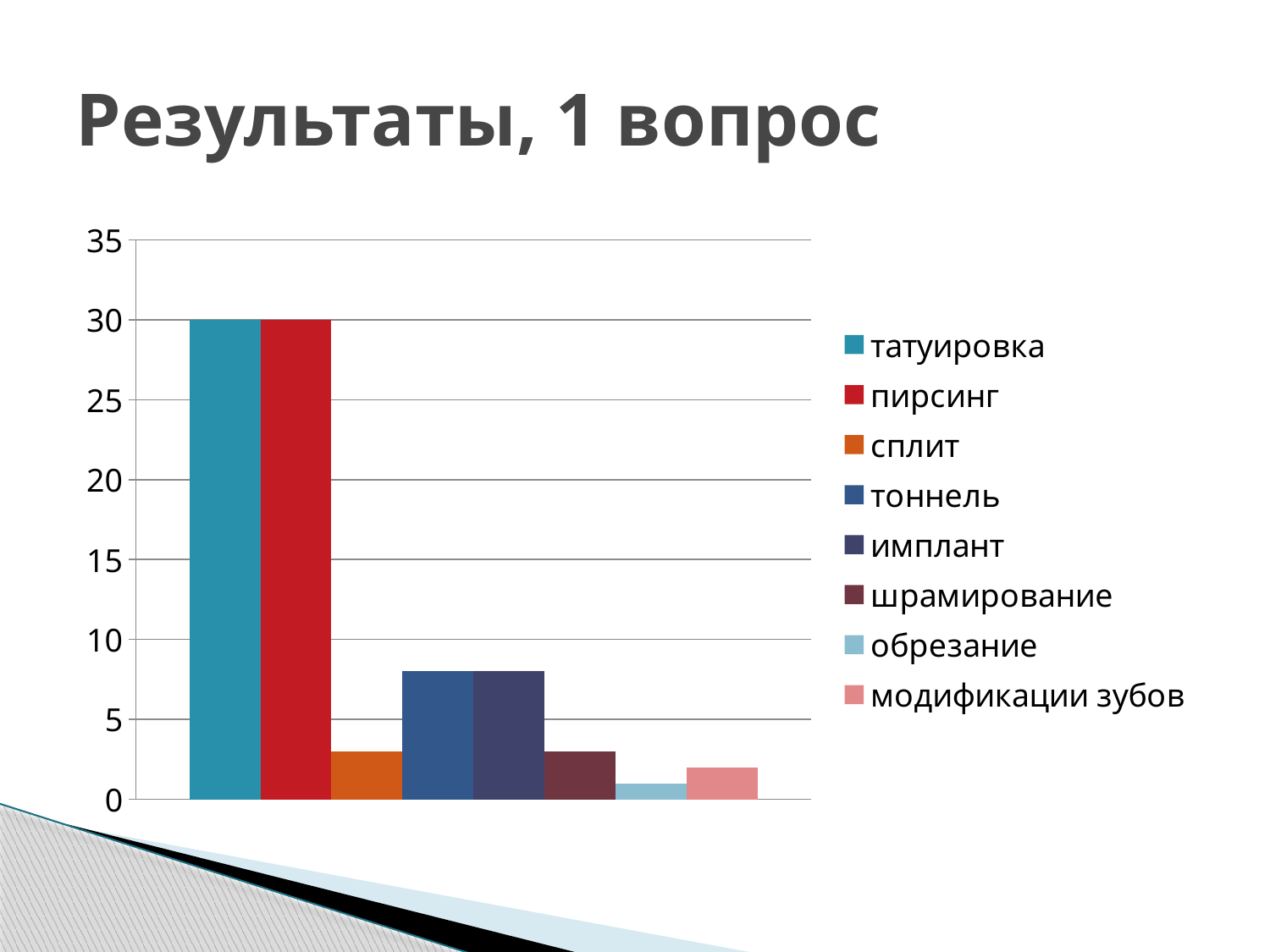
Is the value for имплант greater or less than 10? less What is the value for пирсинг? 30 How many series does the legend list? 8 Which series has the lowest value? обрезание Which is larger, the value for пирсинг or the value for имплант? пирсинг What is the value for татуировка? 30 What is the title of the slide? Результаты, 1 вопрос Is the value for модификации зубов greater or less than 5? less Is the value for тоннель greater or less than 5? greater Which is larger, the value for тоннель or the value for сплит? тоннель What kind of chart is shown on the slide? bar chart